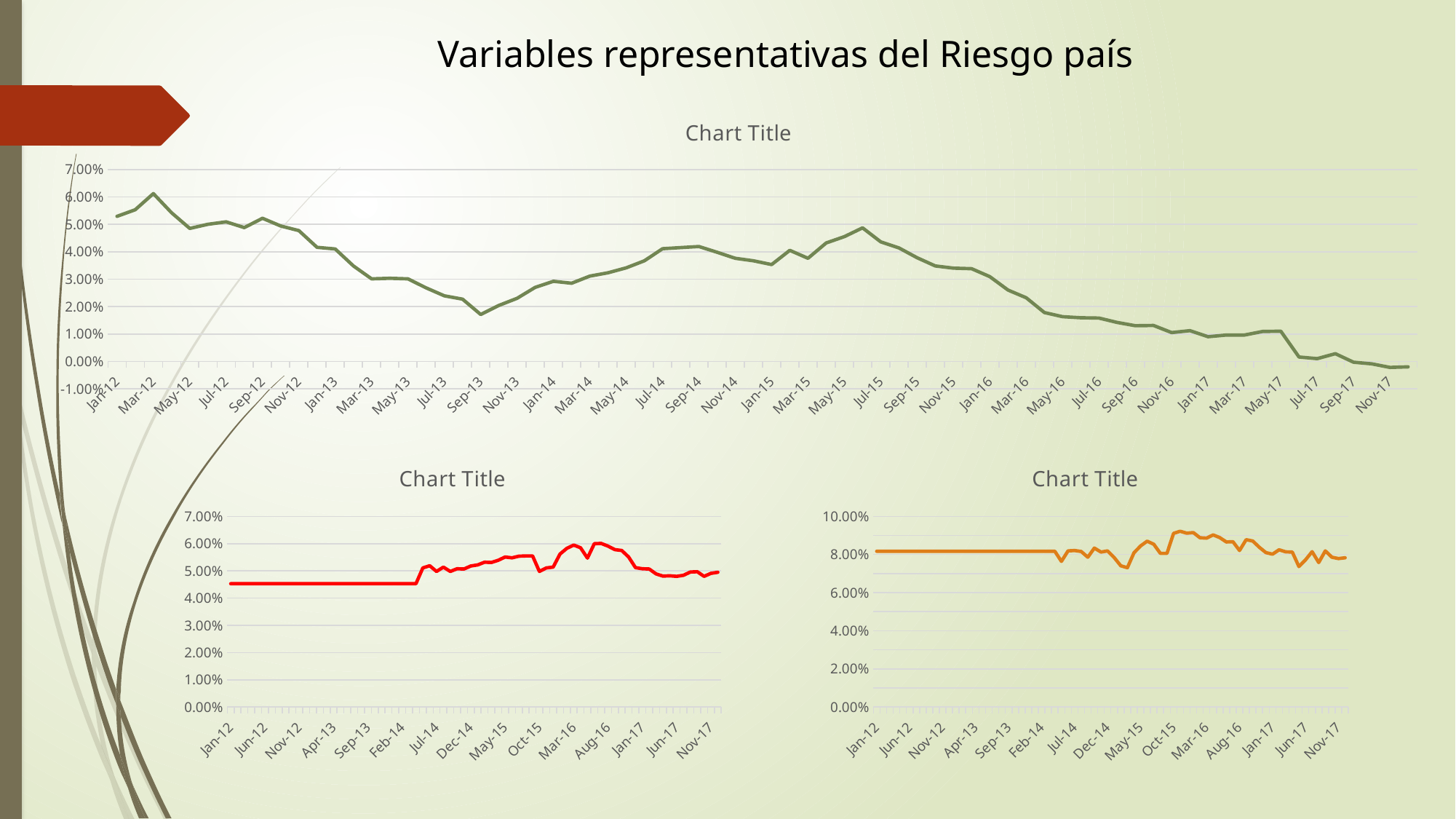
In the top chart, is the value for Sep-13 greater or less than 2.00%? less In the bottom-left chart, is the value for Aug-16 greater or less than 5.00%? greater In the bottom-right chart, is the value for Jan-12 greater or less than 6.00%? greater In the top chart, which is larger, the value for Mar-12 or the value for Jul-15? Mar-12 In the top chart, does the line overall rise or fall from Jan-12 to Nov-17? fall What kind of chart is the top chart on the slide? line chart How many charts are shown on the slide? 3 In the bottom-right chart, which is larger, the value for Oct-15 or the value for Jan-12? Oct-15 What colour is the line in the bottom-left chart? red